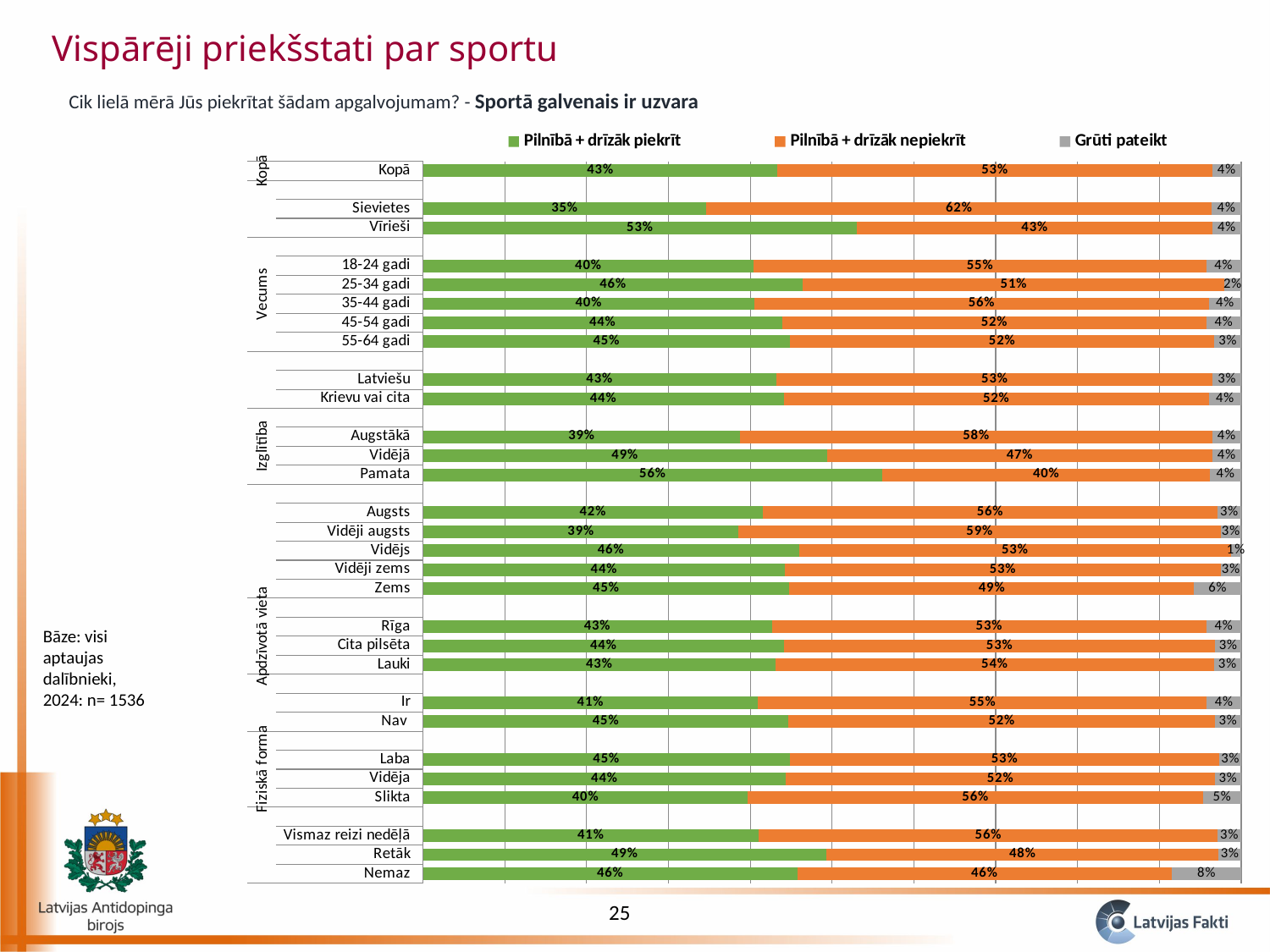
Which is larger: the 'Pilnībā + drīzāk piekrīt' value for Retāk or for Vismaz reizi nedēļā? Retāk What kind of chart is shown on the slide? Stacked bar chart What is the value of 'Pilnībā + drīzāk piekrīt' for Kopā? 43% What is the value of 'Pilnībā + drīzāk nepiekrīt' for Vīrieši? 43% Which category has the lowest value for 'Grūti pateikt'? Vidējs Which category has the highest value for 'Pilnībā + drīzāk piekrīt'? Pamata Which category has the lowest value for 'Pilnībā + drīzāk piekrīt'? Sievietes Which category has the highest value for 'Pilnībā + drīzāk nepiekrīt'? Sievietes What is the difference between the 'Pilnībā + drīzāk piekrīt' values for Vīrieši and Sievietes? 18% How many series does the legend list? 3 What is the value of 'Pilnībā + drīzāk piekrīt' for Sievietes? 35% What is the value of 'Grūti pateikt' for Nemaz? 8%